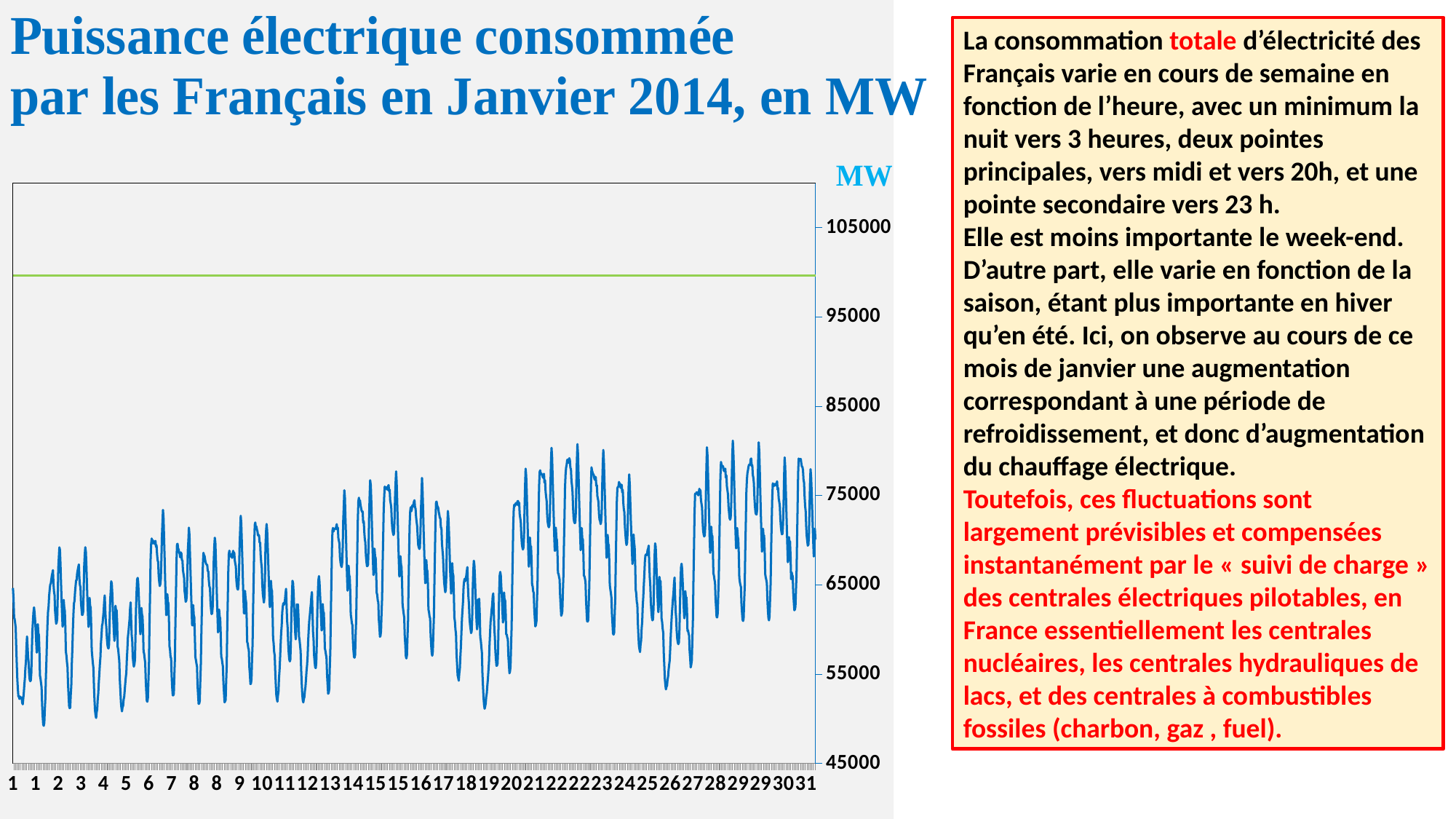
What is the title of the chart on the slide? Puissance électrique consommée par les Français en Janvier 2014, en MW Does the overall level of the blue consumption line rise or fall from the start of the month to the end? rise Is the lowest point of the blue consumption line greater or less than 55000? less What is the highest tick value shown on the vertical axis? 105000 Is the blue consumption line ever above the green horizontal line? no What is the lowest tick value shown on the vertical axis? 45000 What unit is written at the top of the vertical axis? MW Is the green horizontal line greater or less than 105000? less How many days are labelled along the horizontal axis? 31 Is the highest peak of the blue consumption line greater or less than 85000? less What kind of chart is shown on the slide? line chart